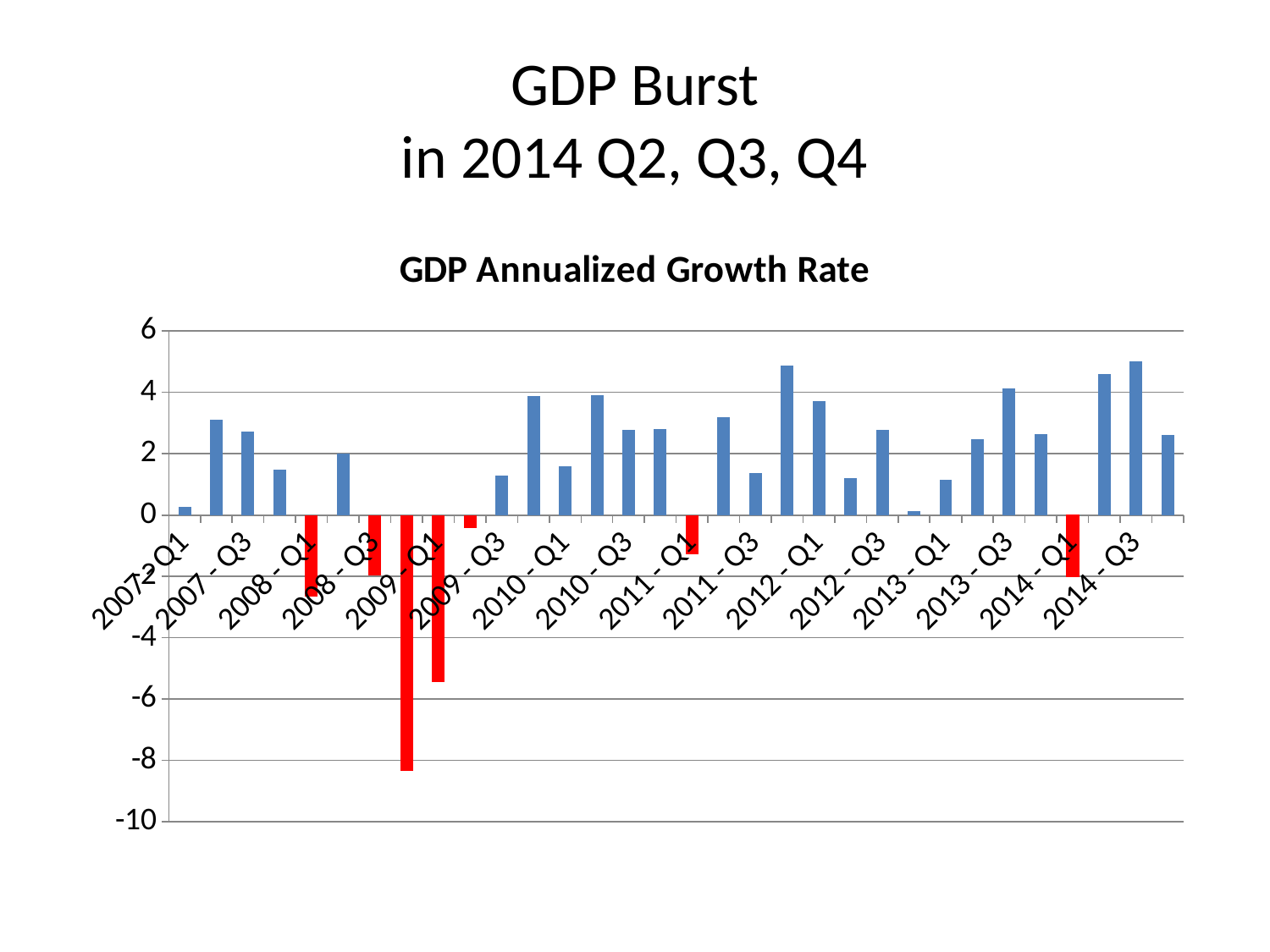
What kind of chart is shown on the slide? bar chart Which is larger, the value for 2008 - Q1 or the value for 2008 - Q2? 2008 - Q2 Which quarter has the lowest GDP annualized growth rate? 2008 - Q4 How many bars are plotted in the chart? 32 Which is larger, the value for 2014 - Q3 or the value for 2014 - Q4? 2014 - Q3 How many bars in the chart are coloured red? 7 Is the value for 2012 - Q1 greater or less than 4? less Is the value for 2009 - Q1 greater or less than -6? greater What is the title of the chart? GDP Annualized Growth Rate Is the value for 2013 - Q1 greater or less than 2? less Do the values rise or fall from 2014 - Q1 to 2014 - Q3? rise